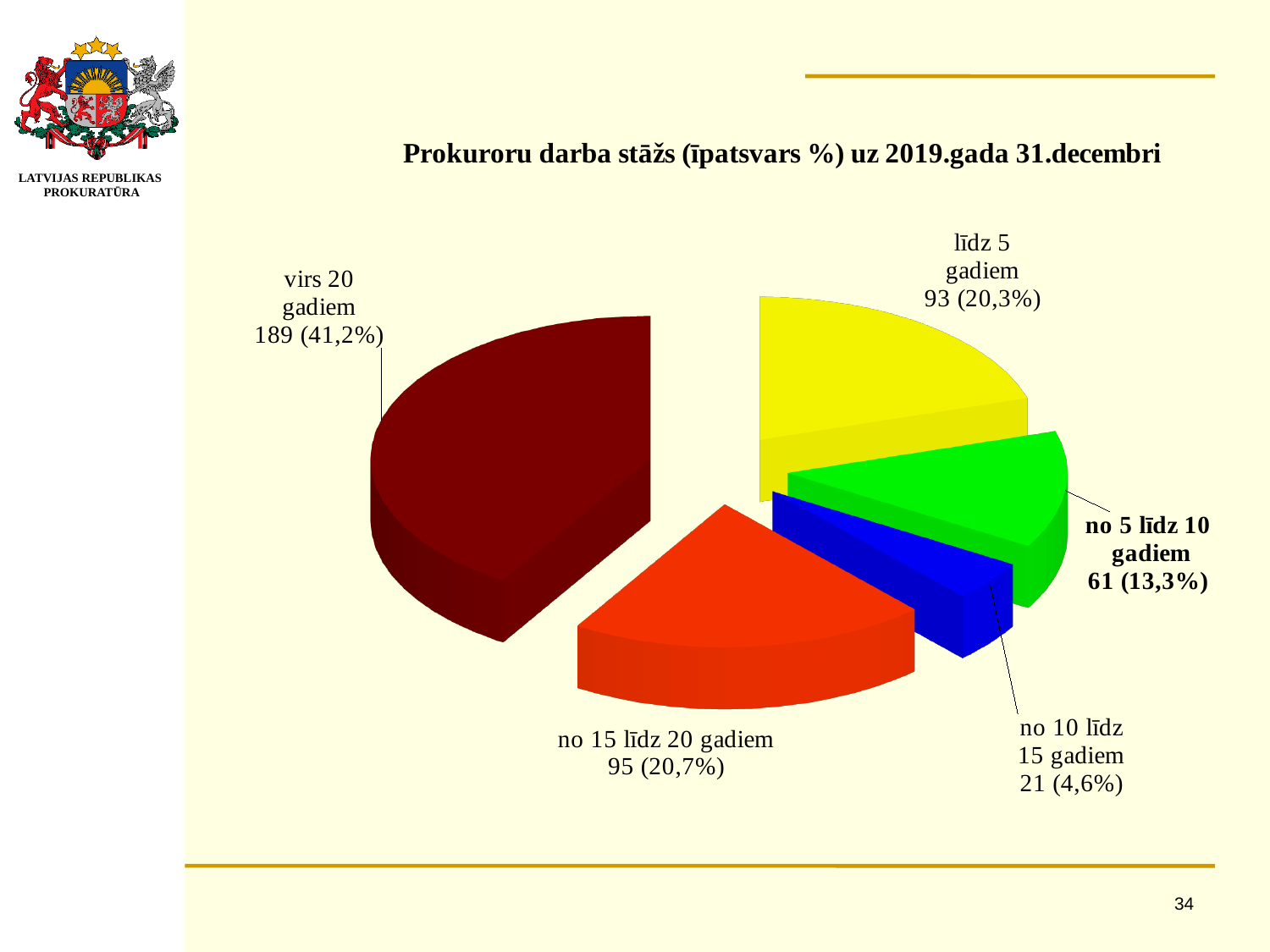
Which category has the largest slice of the pie? virs 20 gadiem What is the total number of prosecutors across all five categories? 459 What is the title of the chart? Prokuroru darba stāžs (īpatsvars %) uz 2019.gada 31.decembri What colour is the "no 15 līdz 20 gadiem" slice? Orange-red What is the value shown for "no 10 līdz 15 gadiem"? 21 (4,6%) Which is larger, the count for "no 5 līdz 10 gadiem" or for "no 10 līdz 15 gadiem"? no 5 līdz 10 gadiem What share of the pie does the "līdz 5 gadiem" slice represent? 20,3% How many slices does the pie chart have? 5 What kind of chart is shown on the slide? Pie chart Which category has the smallest slice of the pie? no 10 līdz 15 gadiem How many prosecutors are in the "virs 20 gadiem" category? 189 What is the difference in count between "virs 20 gadiem" and "no 15 līdz 20 gadiem"? 94